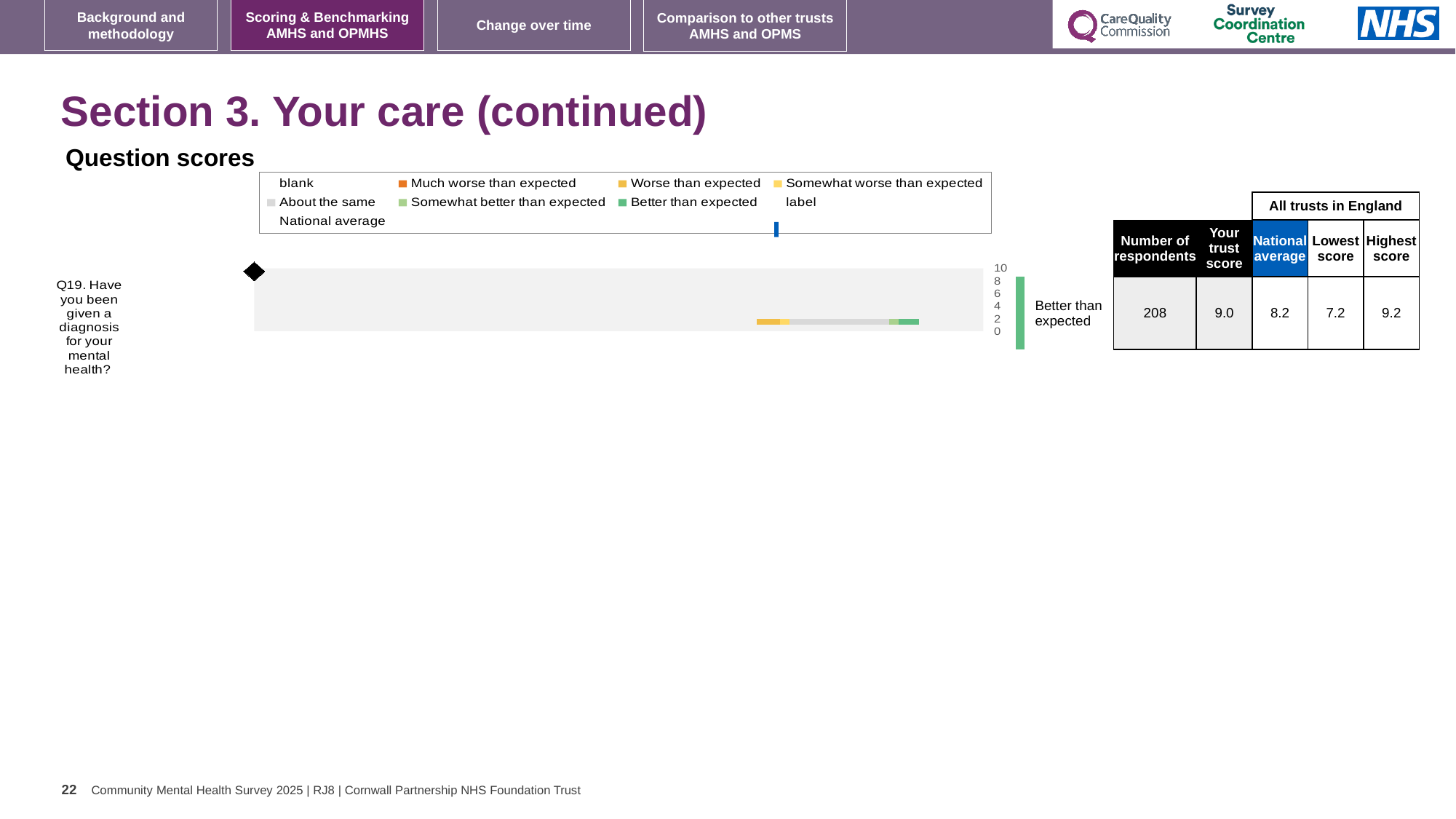
What is the difference between the trust's score and the national average for Q19? 0.8 What is the highest score among all trusts in England for Q19? 9.2 Which question is shown in the Question scores chart? Q19. Have you been given a diagnosis for your mental health? What benchmark category label is shown beside the Q19 bar? Better than expected How many questions are plotted in the Question scores chart? 1 How many respondents answered Q19? 208 What kind of chart is used for the Question scores? bar chart What is the lowest score among all trusts in England for Q19? 7.2 What is the difference between the highest and lowest scores among all trusts for Q19? 2.0 What is the national average for Q19 shown in the table? 8.2 Is the trust's score for Q19 higher or lower than the national average? higher What is the trust's score for Q19 according to the table next to the chart? 9.0